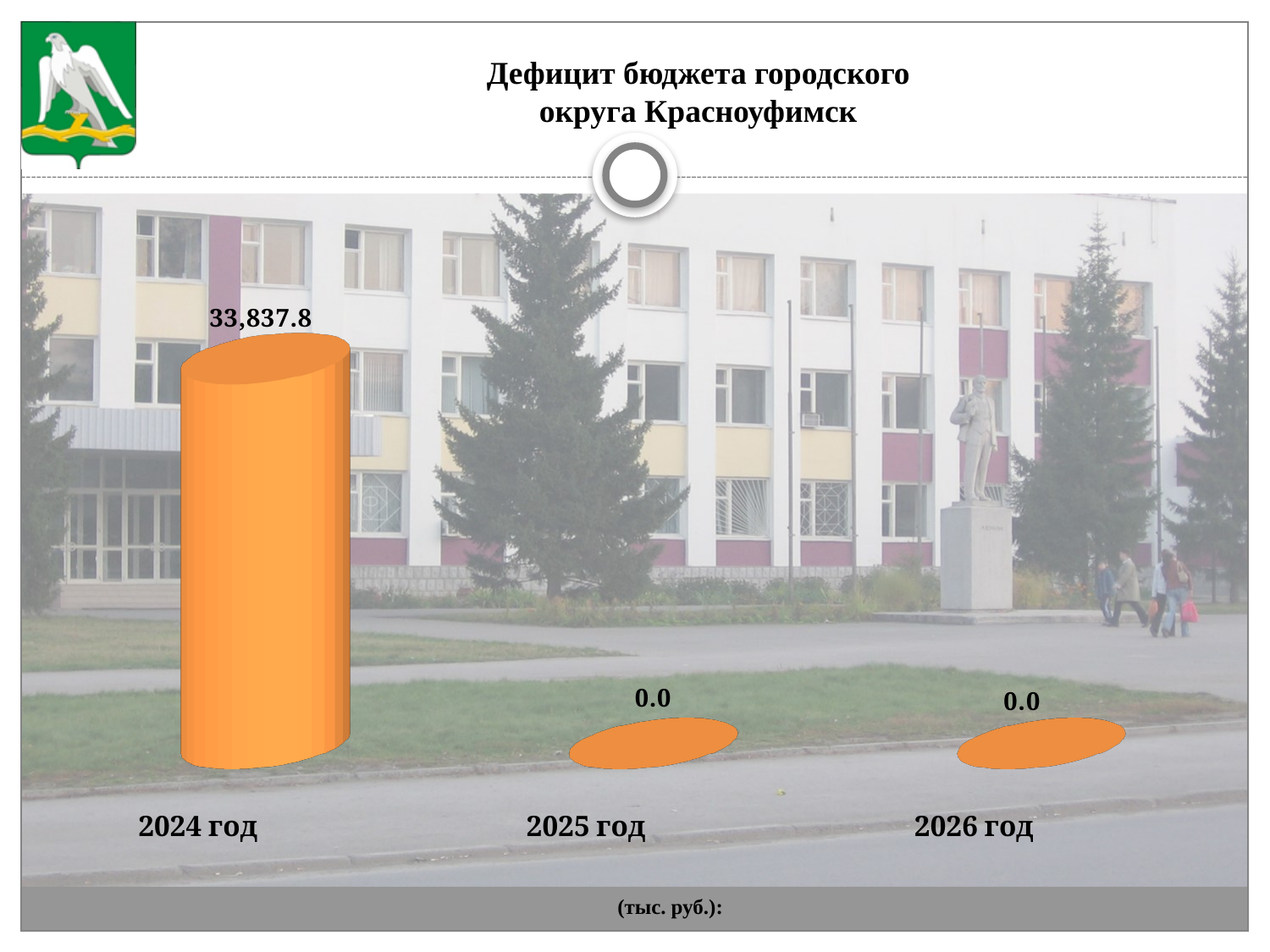
Which year has the highest budget deficit on the chart? 2024 год What is the budget deficit value shown for 2025 год? 0.0 What is the budget deficit value shown for 2024 год? 33,837.8 Which is larger, the deficit for 2024 год or for 2026 год? 2024 год What is the title of the chart? Дефицит бюджета городского округа Красноуфимск In what units are the chart values given, according to the slide? тыс. руб. How many years (categories) are shown on the chart? 3 What is the difference between the deficit for 2024 год and 2025 год? 33,837.8 What is the budget deficit value shown for 2026 год? 0.0 What kind of chart is shown on the slide? Bar chart Do the deficit values rise or fall from 2024 год to 2026 год? Fall